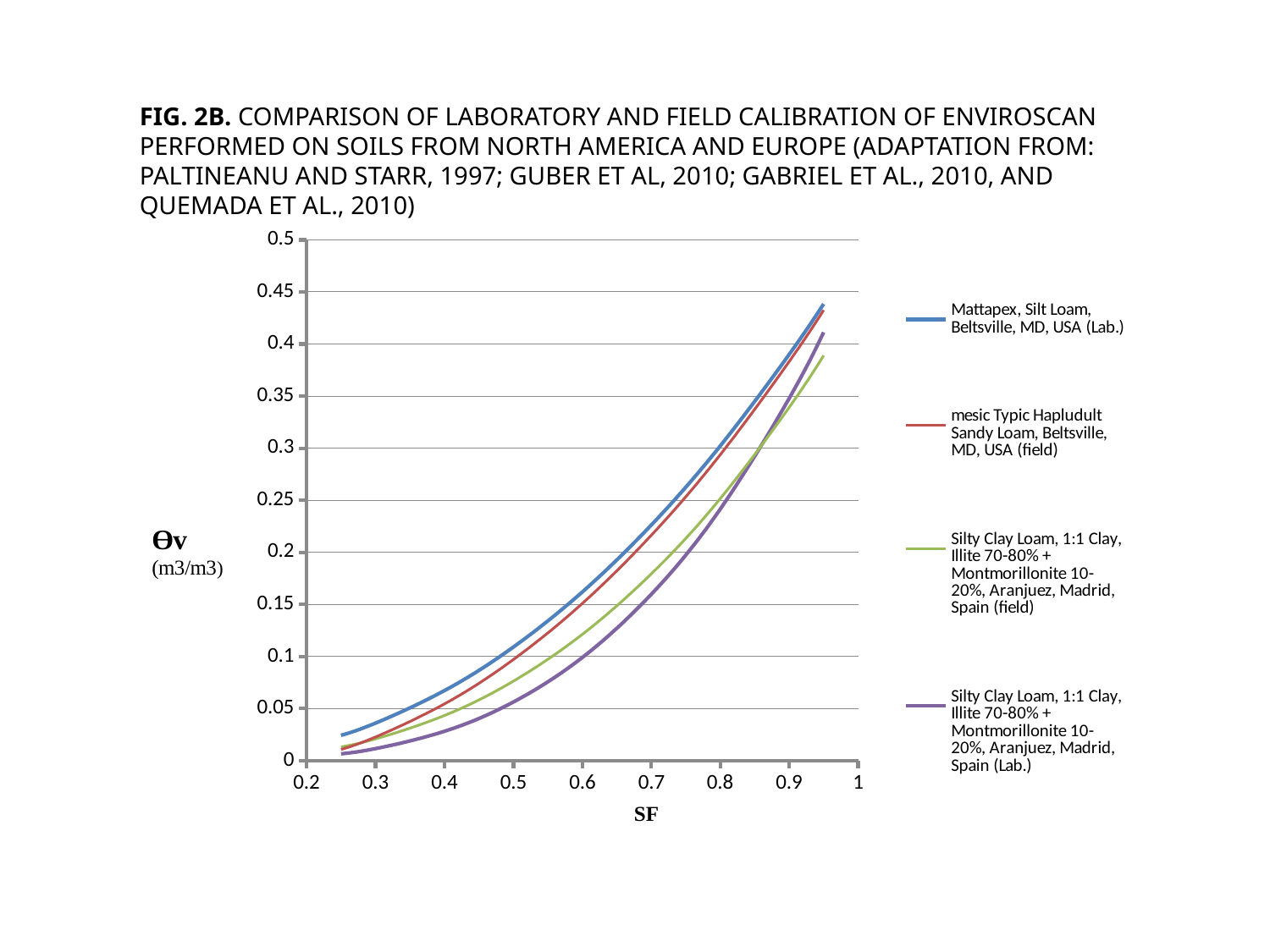
Is the value for Silty Clay Loam, Aranjuez, Madrid, Spain (Lab.) at SF 0.5 greater or less than 0.1? less How many tick labels are shown on the x axis? 9 What is the label of the x axis? SF Is the value for mesic Typic Hapludult Sandy Loam, Beltsville, MD, USA (field) at SF 0.7 greater or less than 0.25? less Is the value for Silty Clay Loam, Aranjuez, Madrid, Spain (field) at SF 0.95 greater or less than 0.35? greater What kind of chart is shown on the slide? line chart Which series has the lowest value at SF 0.6? Silty Clay Loam, 1:1 Clay, Illite 70-80% + Montmorillonite 10-20%, Aranjuez, Madrid, Spain (Lab.) How many series does the legend list? 4 Do the plotted values rise or fall as SF increases along the x axis? rise Which series is drawn in blue? Mattapex, Silt Loam, Beltsville, MD, USA (Lab.) At SF 0.6, which is larger: the value for Mattapex, Silt Loam (Lab.) or the value for Silty Clay Loam, Aranjuez, Madrid, Spain (Lab.)? Mattapex, Silt Loam (Lab.)